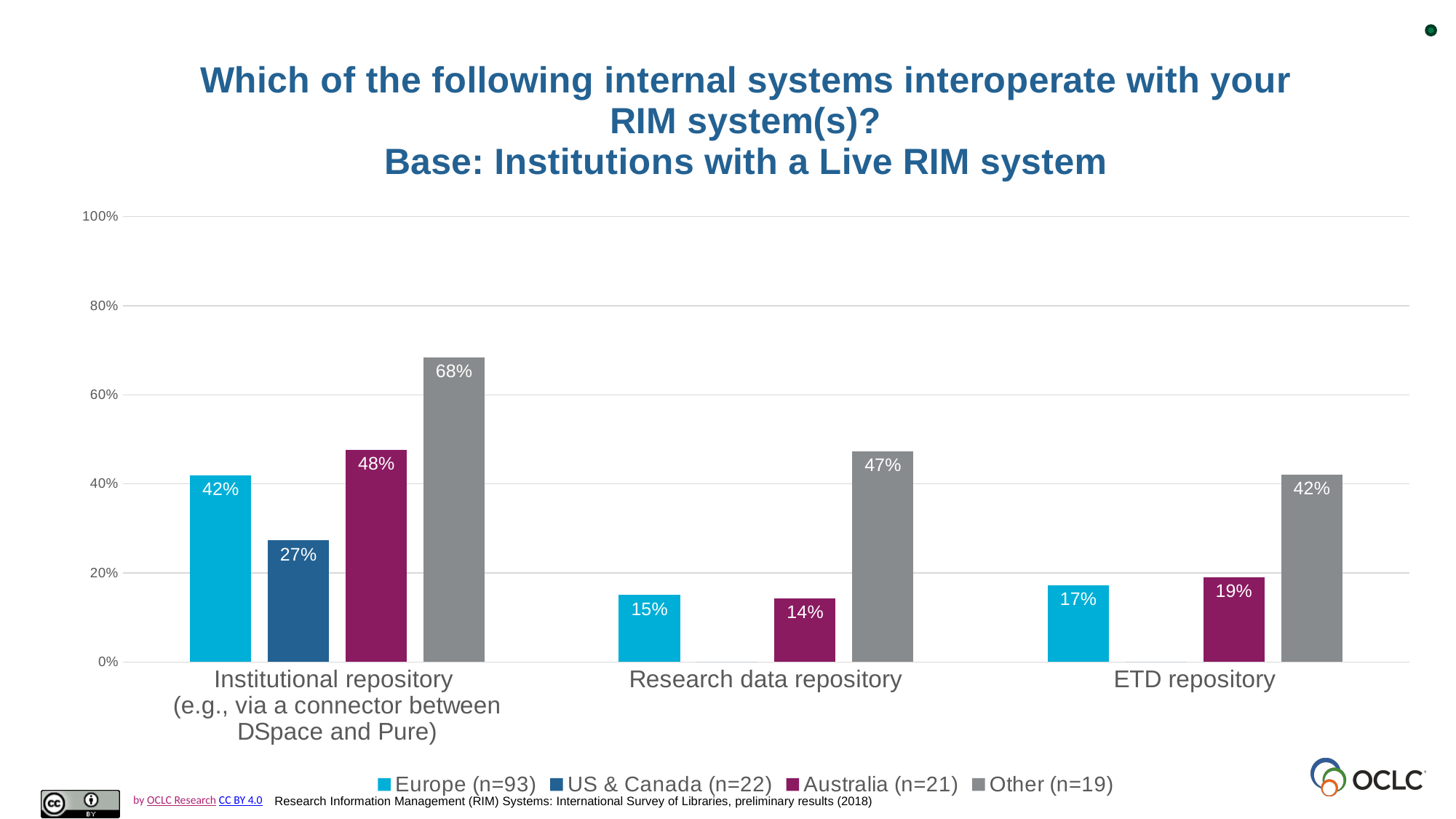
Which region has the highest value for Institutional repository? Other (n=19) What kind of chart is shown on the slide? Bar chart How many series does the legend list? 4 Which is larger for ETD repository: Europe (n=93) or Australia (n=21)? Australia (n=21) What colour are the bars for Australia (n=21)? Purple What is the value for Other (n=19) for Institutional repository? 68% What is the value for Europe (n=93) for Research data repository? 15% What is the value for US & Canada (n=22) for Institutional repository? 27% How many categories are shown on the x axis? 3 What is the difference between the Other (n=19) and Europe (n=93) values for Institutional repository? 26% What is the value for Australia (n=21) for ETD repository? 19%